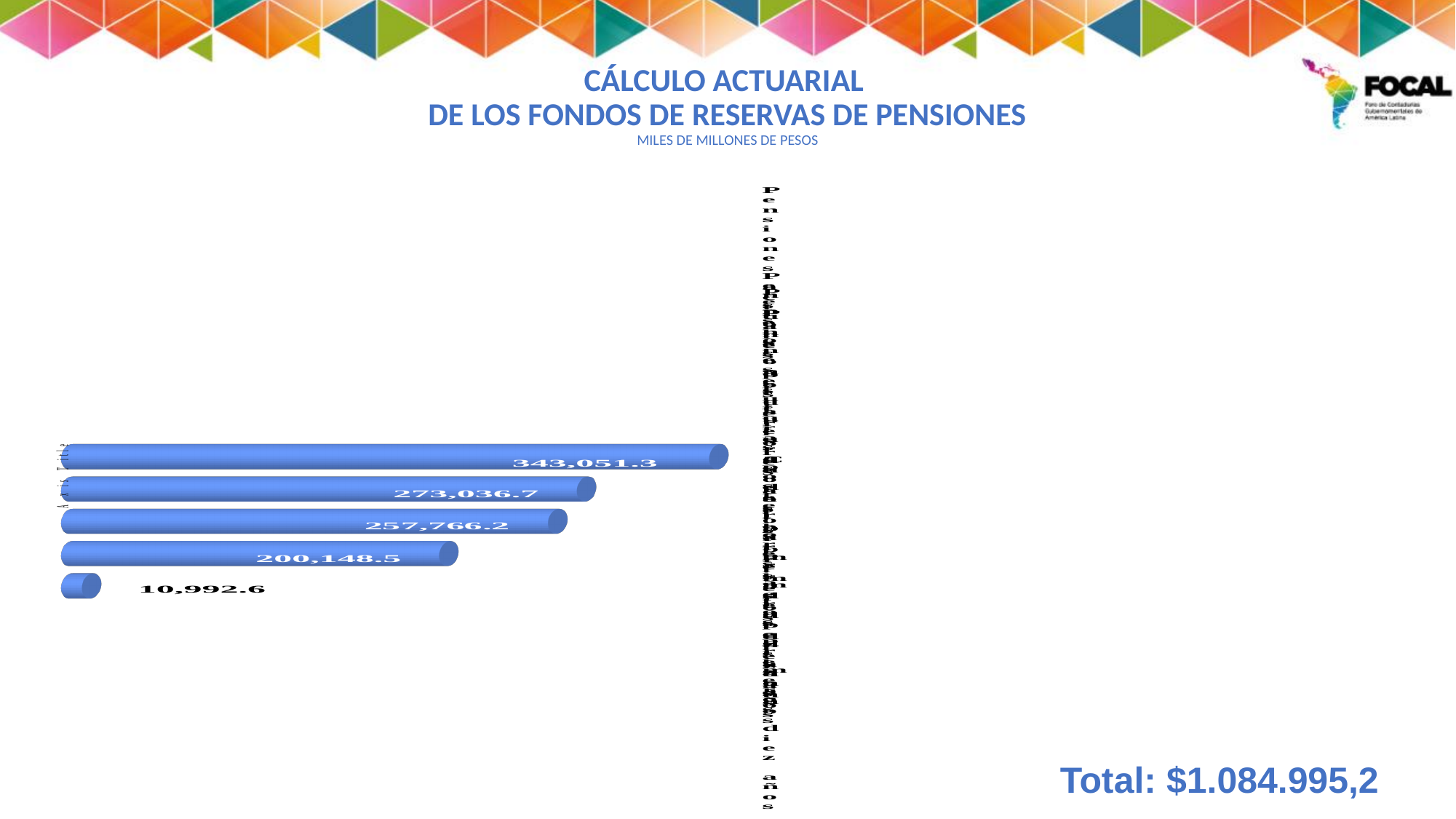
What is the highest value shown in the chart? 343,051.3 What is the value of the fourth bar from the top in the chart? 200,148.5 What is the value of the middle (third) bar in the chart? 257,766.2 How many bars does the chart show? 5 What is the value of the second bar from the top in the chart? 273,036.7 What is the value of the bottom (shortest) bar in the chart? 10,992.6 What kind of chart is shown on the slide? bar chart What unit is stated under the chart title on the slide? MILES DE MILLONES DE PESOS What is the lowest value shown in the chart? 10,992.6 What is the value of the top (longest) bar in the chart? 343,051.3 What is the difference between the top bar (343,051.3) and the second bar (273,036.7)? 70,014.6 Do the bar values increase or decrease going from the top bar to the bottom bar? decrease